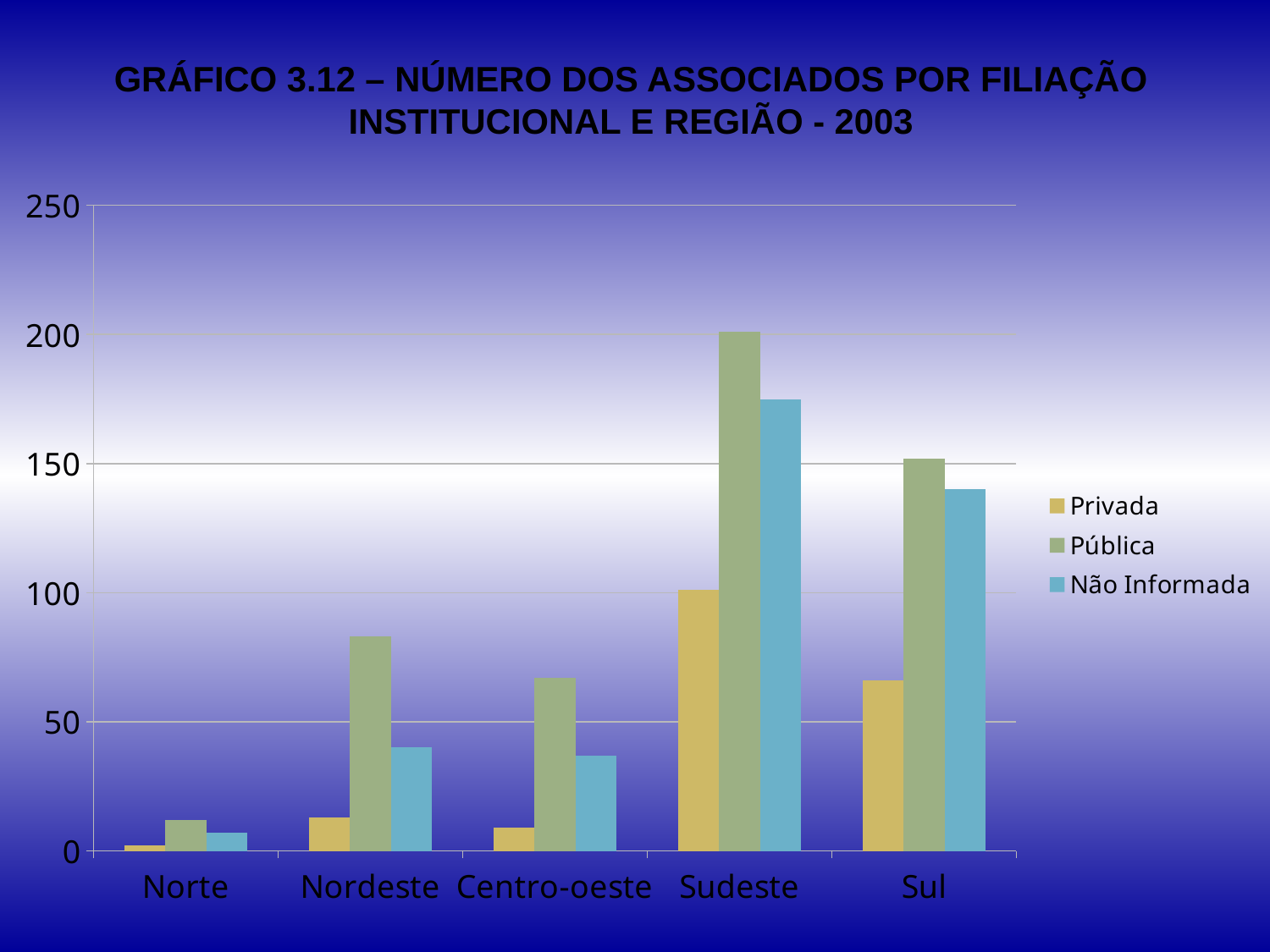
Is the value for Pública in Nordeste greater or less than 50? greater Which is larger, the Pública value for Nordeste or the Pública value for Centro-oeste? Nordeste How many regions are shown on the x axis? 5 Is the value for Não Informada in Sul greater or less than 150? less How many series does the legend list? 3 Which region has the highest value for Pública? Sudeste Which region has the lowest value for Privada? Norte What kind of chart is shown on the slide? bar chart In Sul, which is larger, the Pública value or the Não Informada value? Pública Is the value for Não Informada in Sudeste greater or less than 150? greater Which region has the highest value for Não Informada? Sudeste Which series are listed in the legend? Privada, Pública, Não Informada